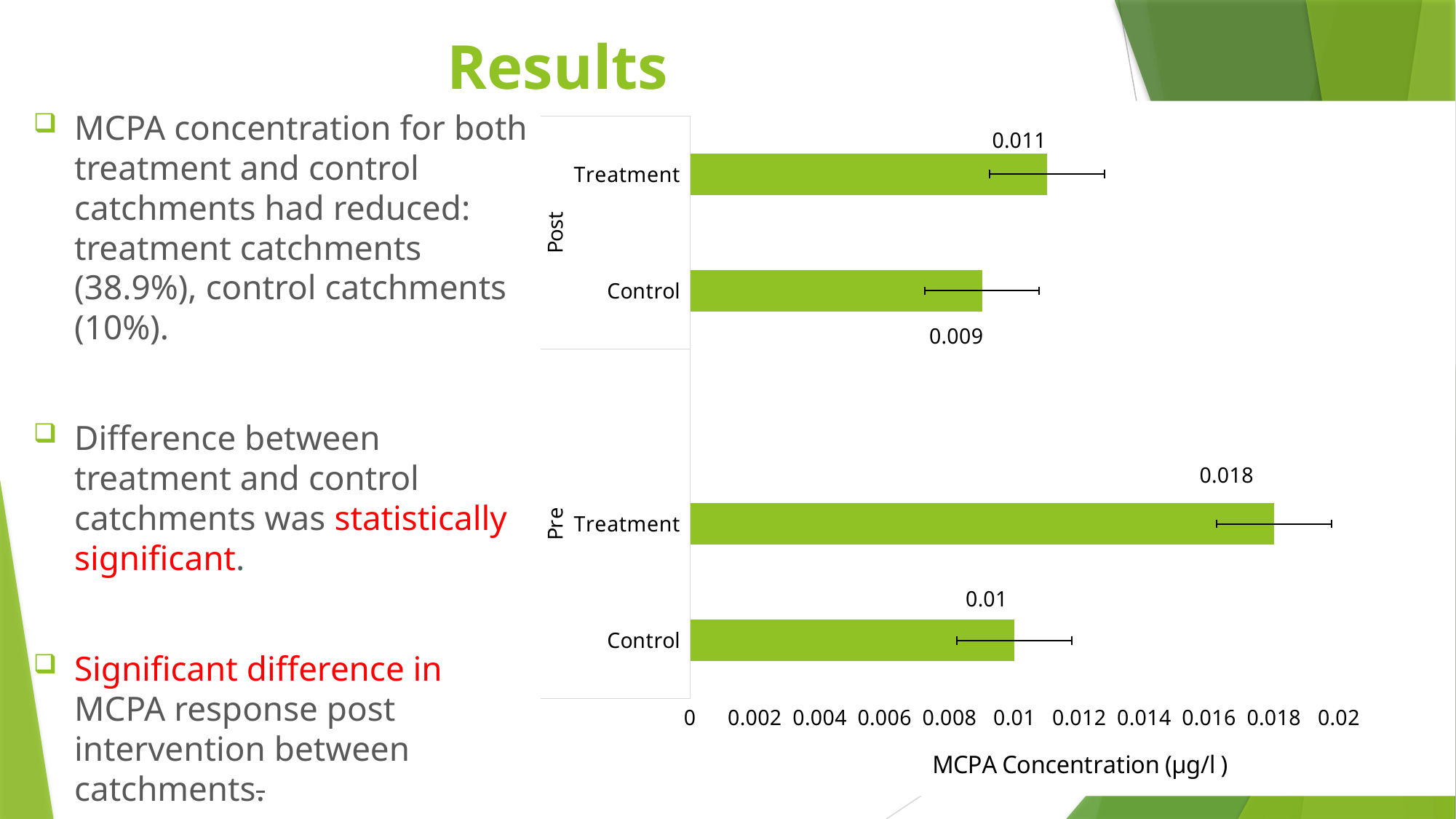
What is the label of the horizontal axis of the chart? MCPA Concentration (µg/l ) What is the MCPA concentration for the Pre Control bar? 0.01 What is the MCPA concentration for the Post Treatment bar? 0.011 Which is larger, the Pre Treatment value or the Pre Control value? Pre Treatment What is the MCPA concentration for the Post Control bar? 0.009 Which bar has the lowest MCPA concentration? Post Control What kind of chart is shown on the slide? Bar chart Is the value for Pre Treatment greater or less than 0.016? greater How many bars are plotted in the chart? 4 What is the MCPA concentration for the Pre Treatment bar? 0.018 What is the difference in MCPA concentration between Pre Treatment and Post Treatment? 0.007 Which bar has the highest MCPA concentration? Pre Treatment